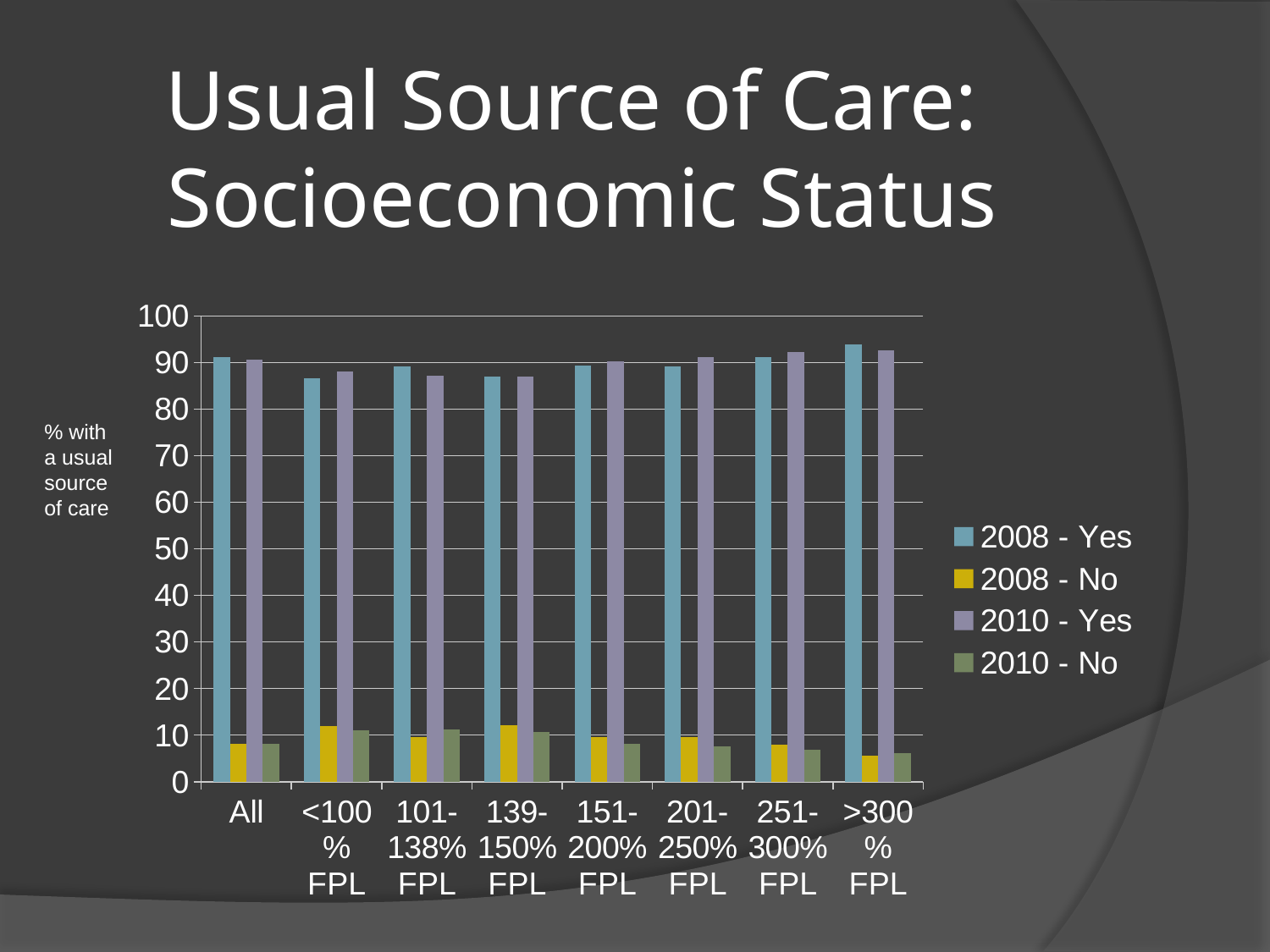
How many series does the legend list? 4 Is the 2010 - No value for All greater or less than 10? less Which category has the lowest value for the 2008 - No series? >300% FPL Is the 2008 - Yes value for <100% FPL greater or less than 90? less For the 139-150% FPL category, which is larger: the 2008 - No value or the 2010 - No value? 2008 - No How many income categories are shown on the x axis? 8 What is the label on the vertical axis of the chart? % with a usual source of care Which category has the highest value for the 2008 - Yes series? >300% FPL Is the 2008 - Yes value for >300% FPL greater or less than 90? greater For the 2008 - Yes series, which is larger: the value for >300% FPL or the value for All? >300% FPL What kind of chart is shown on the slide? bar chart